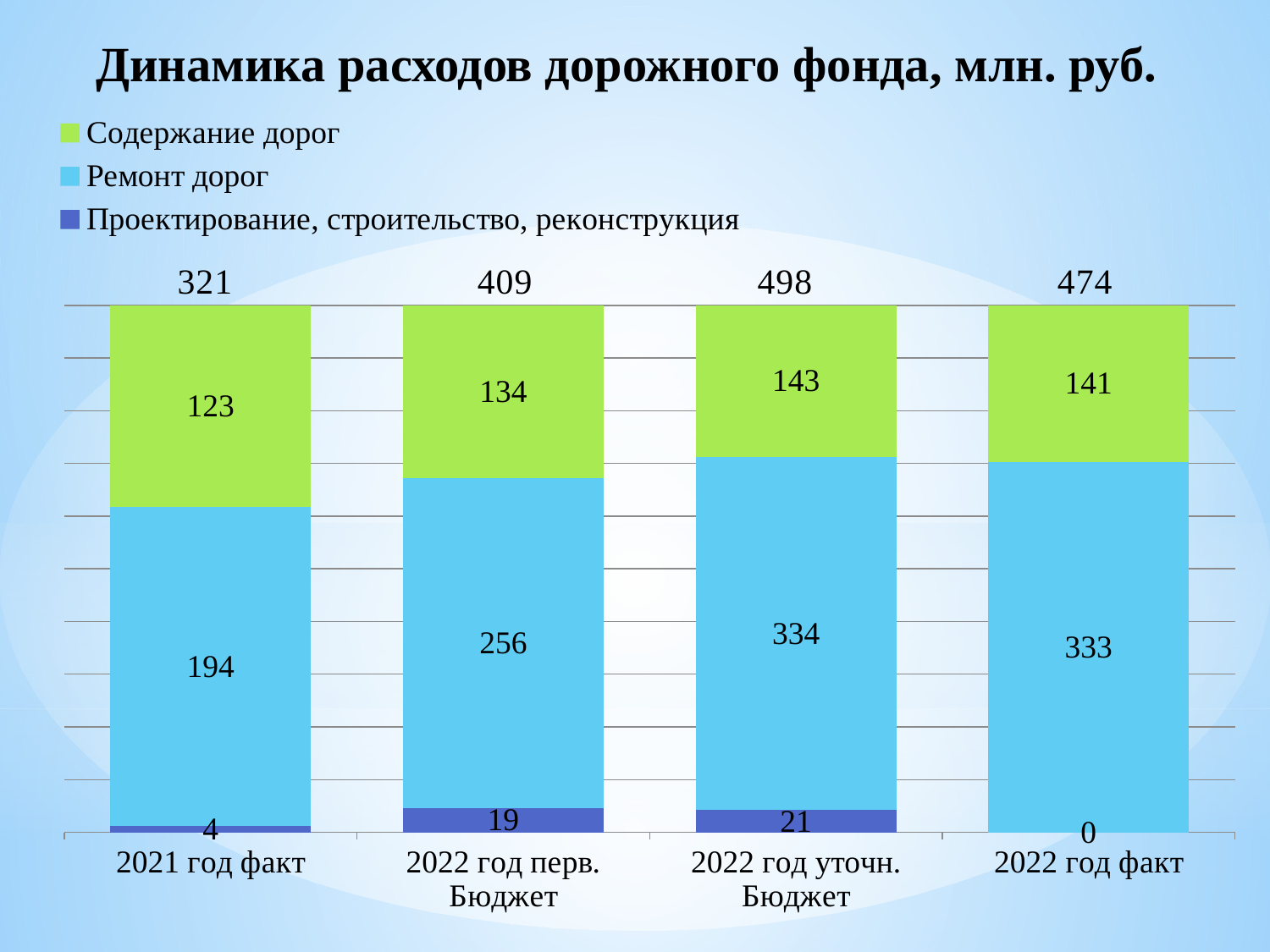
What is the value of Ремонт дорог for 2022 год уточн. Бюджет? 334 How many categories are shown on the x axis? 4 What is the value of Проектирование, строительство, реконструкция for 2022 год перв. Бюджет? 19 What type of chart is shown on the slide? stacked bar chart What is the total shown above the bar for 2022 год факт? 474 What is the title of the chart? Динамика расходов дорожного фонда, млн. руб. What is the value of Содержание дорог for 2021 год факт? 123 What is the difference between the totals for 2022 год уточн. Бюджет and 2021 год факт? 177 How many series does the legend list? 3 Which is larger: Ремонт дорог for 2022 год перв. Бюджет or for 2022 год факт? 2022 год факт Which category has the lowest total? 2021 год факт Which category has the highest total? 2022 год уточн. Бюджет